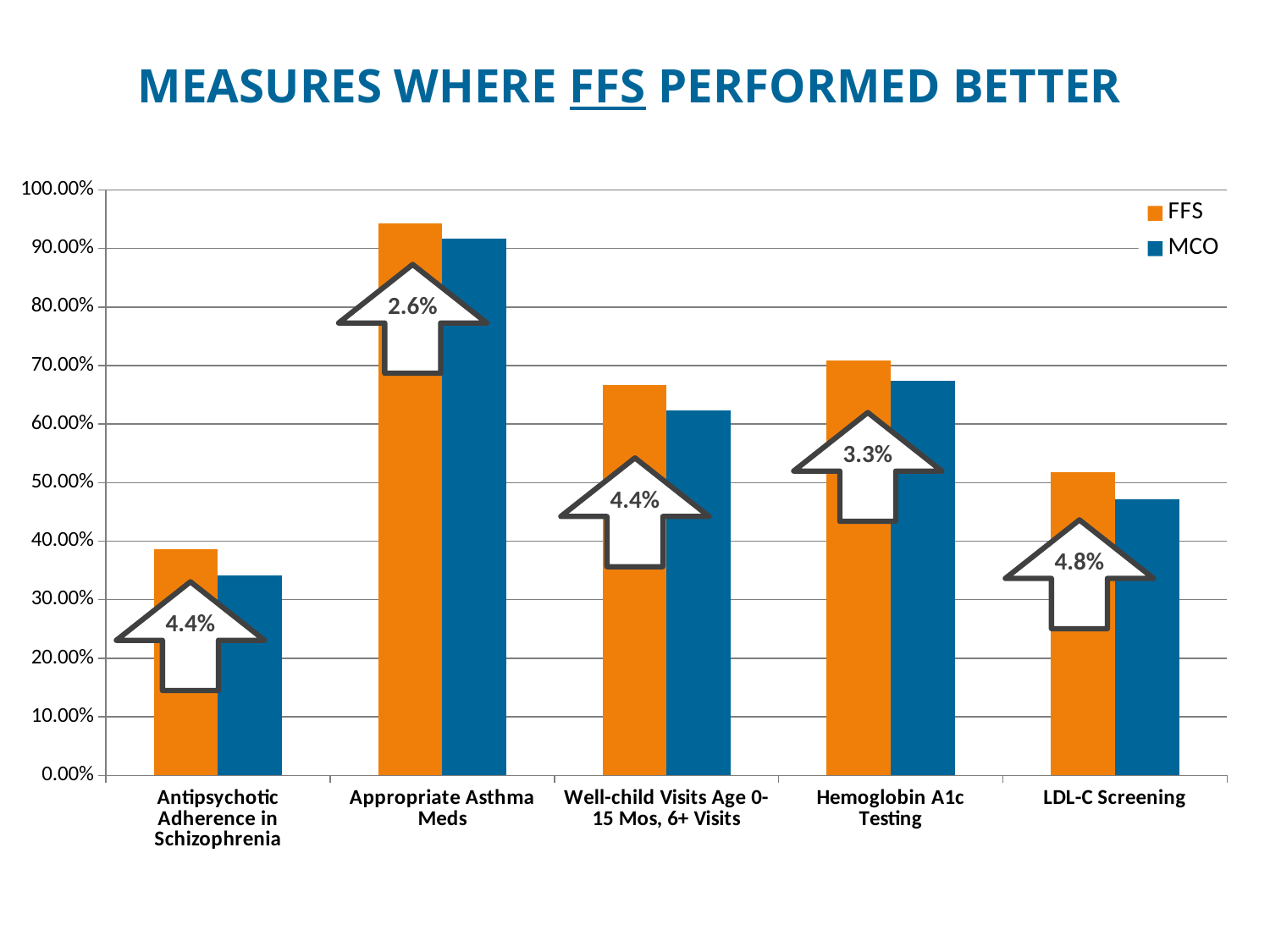
According to the arrow label, by how much did FFS outperform MCO on LDL-C Screening? 4.8% Is the FFS value for Well-child Visits Age 0-15 Mos, 6+ Visits greater or less than 60.00%? greater Which measure has the highest FFS value? Appropriate Asthma Meds Which measure has the lowest MCO value? Antipsychotic Adherence in Schizophrenia Is the MCO value for LDL-C Screening greater or less than 50.00%? less What kind of chart is shown on the slide? bar chart How many measures (categories) are shown on the x axis? 5 Is the FFS value for Appropriate Asthma Meds greater or less than 90.00%? greater How many series does the legend list? 2 Which series is shown in orange in the legend? FFS For Hemoglobin A1c Testing, which is larger, the FFS value or the MCO value? FFS